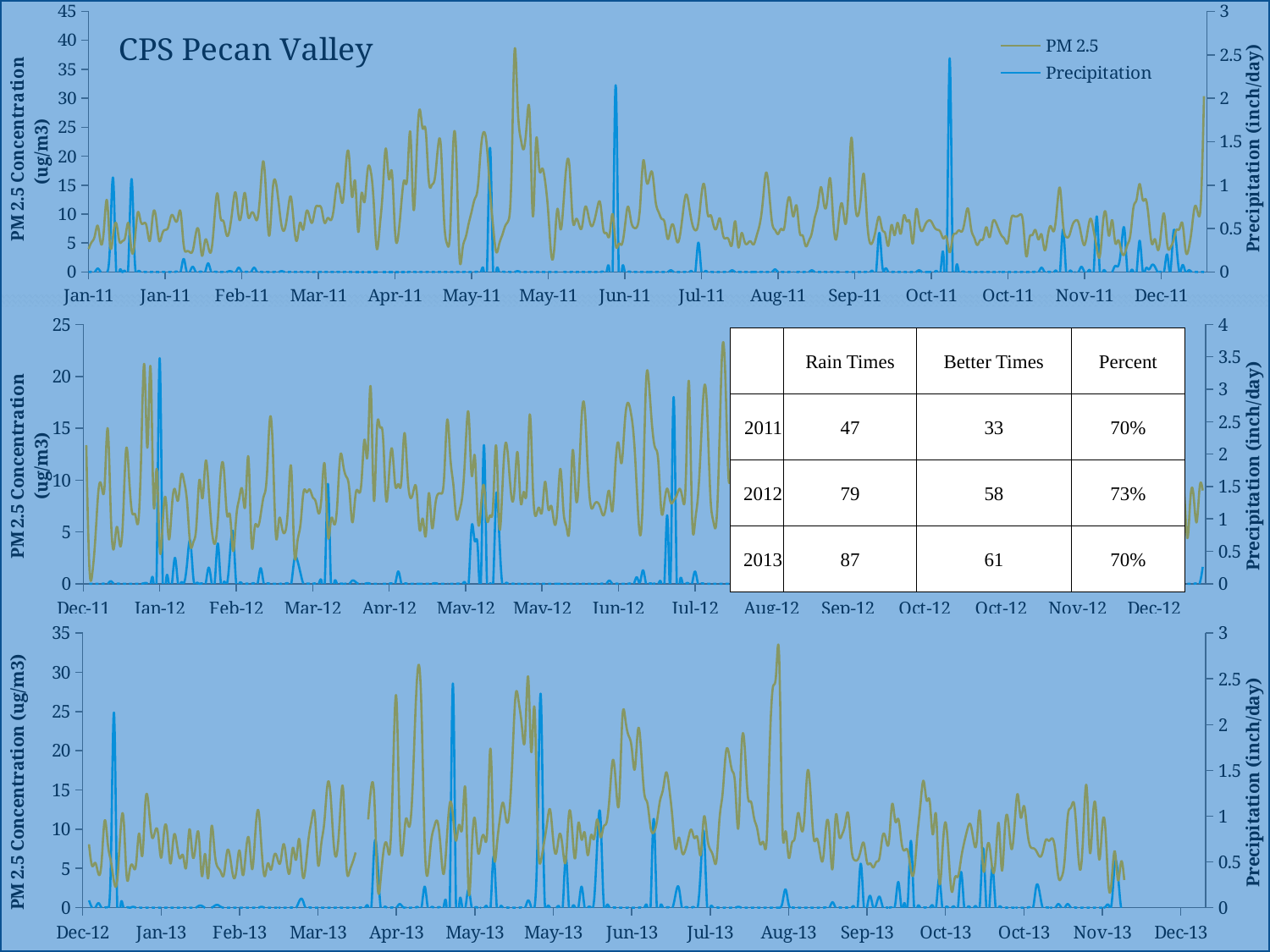
In the top chart, is the highest PM 2.5 value (around May-11) greater or less than 35? greater In the bottom chart, is the highest PM 2.5 value (around Aug-13) greater or less than 30? greater In the top chart, is the highest Precipitation spike (around Oct-11) greater or less than 2? greater In the top chart, which series is drawn in blue according to the legend? Precipitation What is the title shown on the top chart? CPS Pecan Valley How many series does the legend of the top chart list? 2 How many line charts are shown on the slide? 3 What kind of chart is the top chart on the slide? line chart